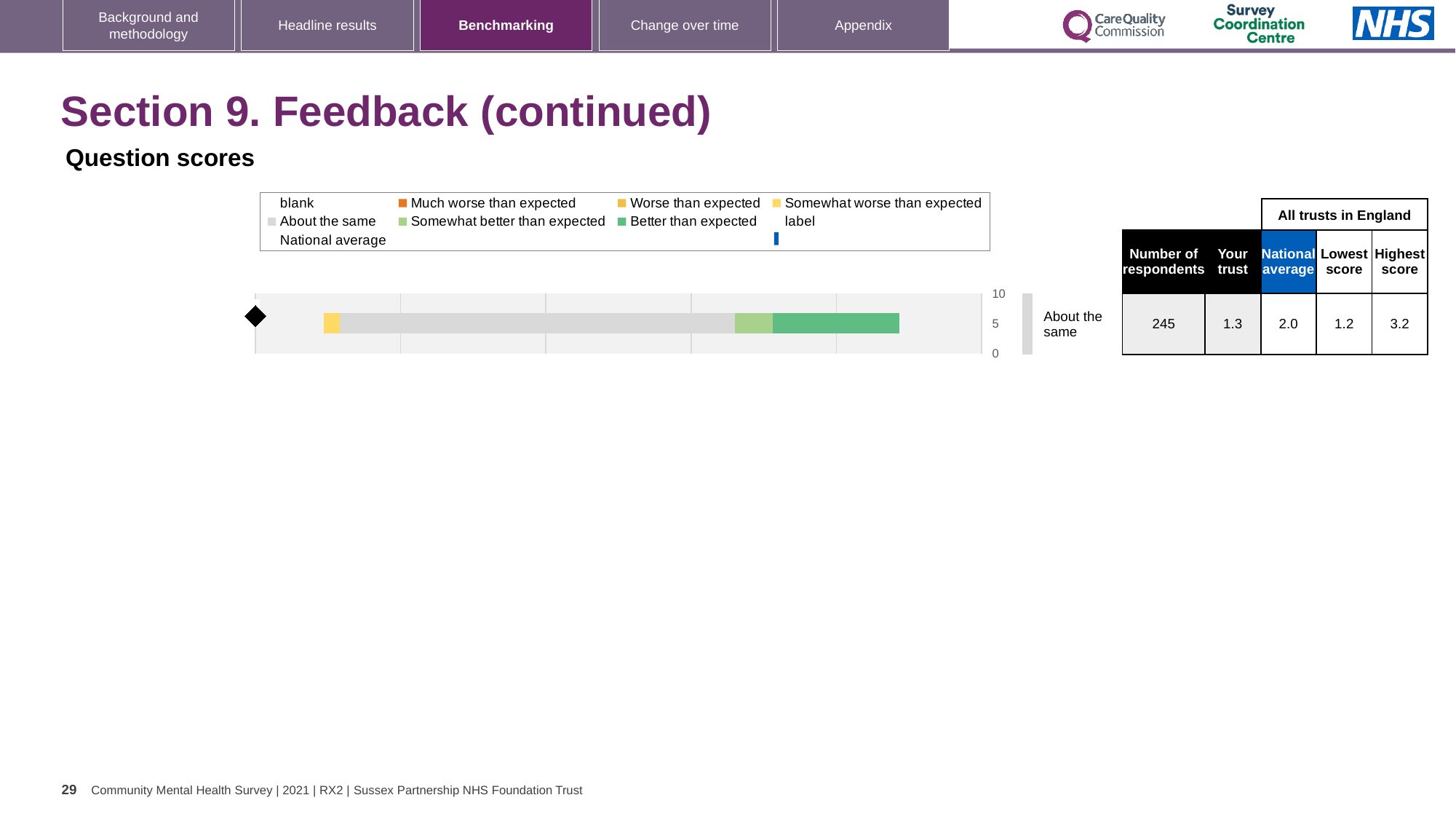
Is the 'Your trust' score higher or lower than the National average? lower How many question categories are plotted in the chart? 1 What is the label of the single category plotted in the chart? About the same What is the difference between the Highest score and the Lowest score in the table? 2.0 In the table next to the chart, what is the Number of respondents for 'About the same'? 245 In the table next to the chart, what is the Lowest score among all trusts in England? 1.2 In the table next to the chart, what is the Highest score among all trusts in England? 3.2 What kind of chart is shown on the slide? bar chart In the table next to the chart, what is the National average for 'About the same'? 2.0 Which legend entry is shown in grey? About the same What is the difference between the National average and the 'Your trust' score? 0.7 In the table next to the chart, what is the 'Your trust' score for 'About the same'? 1.3